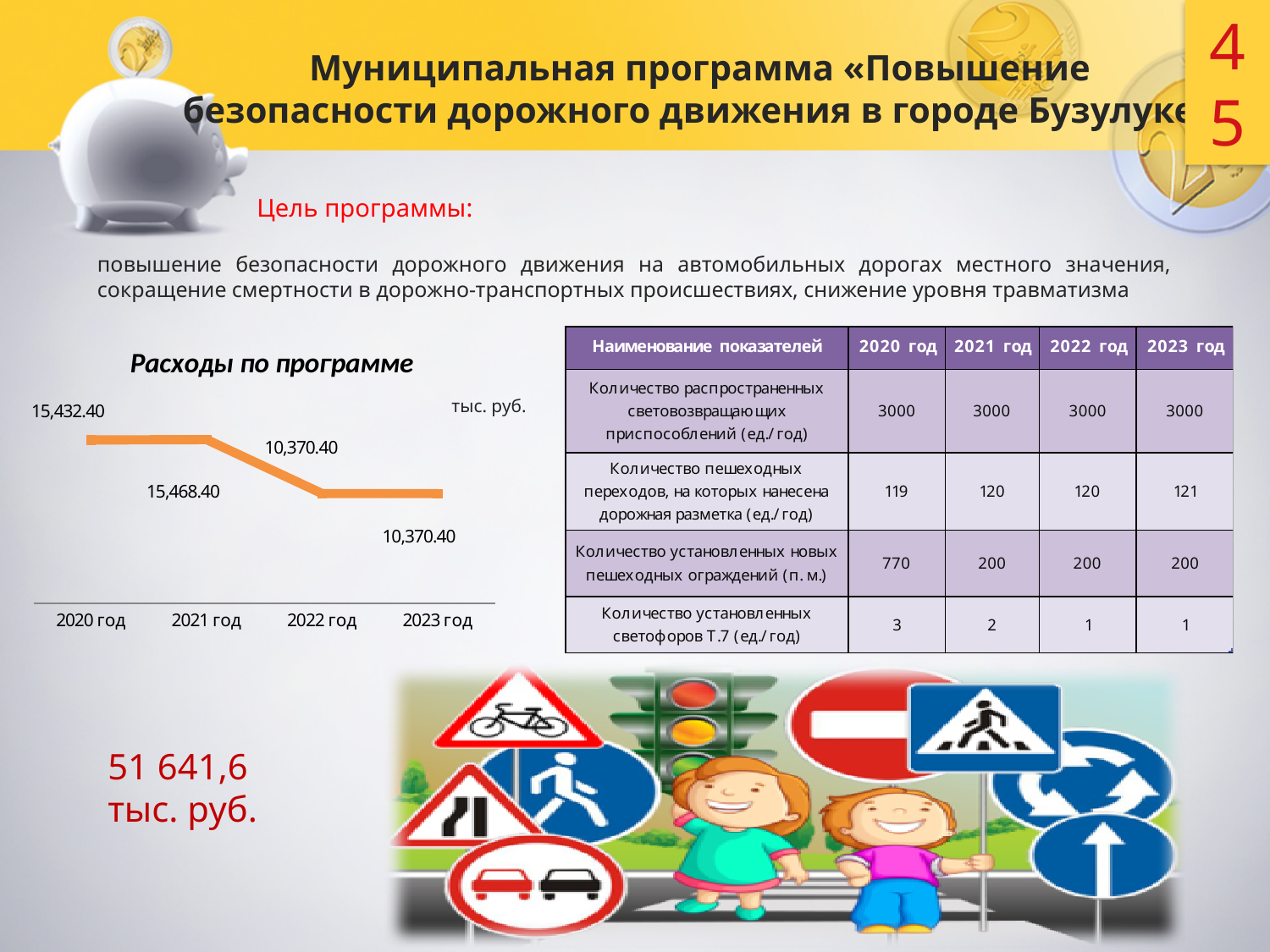
What is the value for 2023 год in the chart 'Расходы по программе'? 10,370.40 Which year has the highest value in the chart 'Расходы по программе'? 2021 год What is the difference between the values for 2021 год and 2020 год in the chart 'Расходы по программе'? 36.00 Do the values in the chart 'Расходы по программе' rise or fall from 2020 год to 2023 год? fall What is the difference between the values for 2020 год and 2022 год in the chart 'Расходы по программе'? 5,062.00 What kind of chart is 'Расходы по программе'? line chart In the chart 'Расходы по программе', which is larger: the value for 2020 год or the value for 2023 год? 2020 год What unit is shown for the values in the chart 'Расходы по программе'? тыс. руб. How many years are plotted in the chart 'Расходы по программе'? 4 What is the value for 2022 год in the chart 'Расходы по программе'? 10,370.40 What is the value for 2020 год in the chart 'Расходы по программе'? 15,432.40 What is the value for 2021 год in the chart 'Расходы по программе'? 15,468.40